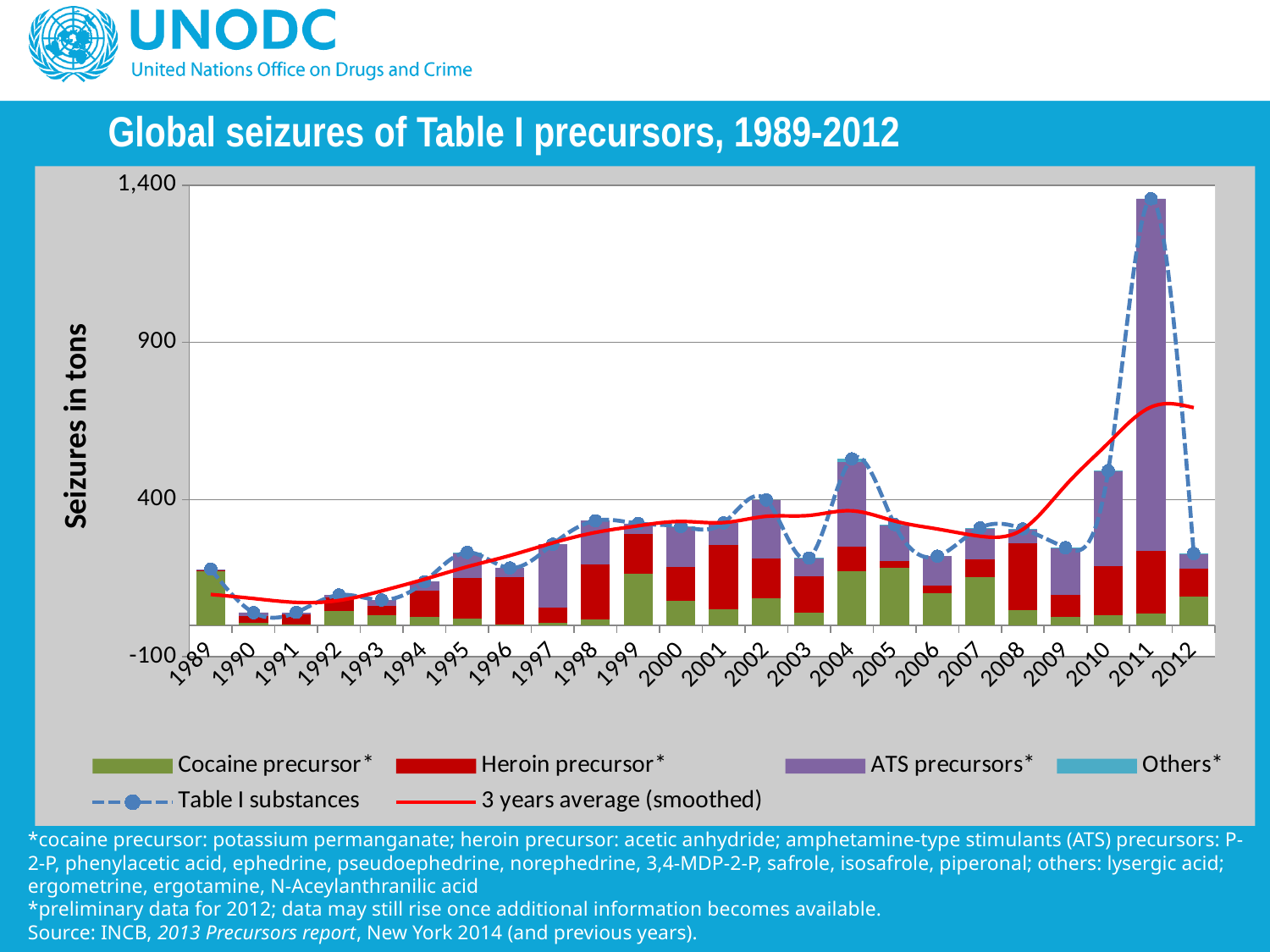
What is the title of the chart? Global seizures of Table I precursors, 1989-2012 Which series makes up the largest part of the 2011 bar? ATS precursors Is the total seizure value for 2011 greater or less than 900 tons? greater How many years are shown along the x axis? 24 Is the total seizure value for 2003 greater or less than 400 tons? less Which year has the highest total seizures of Table I substances? 2011 Is the total seizure value for 2004 greater or less than 400 tons? greater What is the label on the y axis? Seizures in tons How many series does the legend list? 6 Between 2009 and 2011, does the Table I substances line rise or fall? rise Which year has the larger total seizures, 2004 or 2011? 2011 What kind of chart is shown on the slide? Stacked bar chart with line series